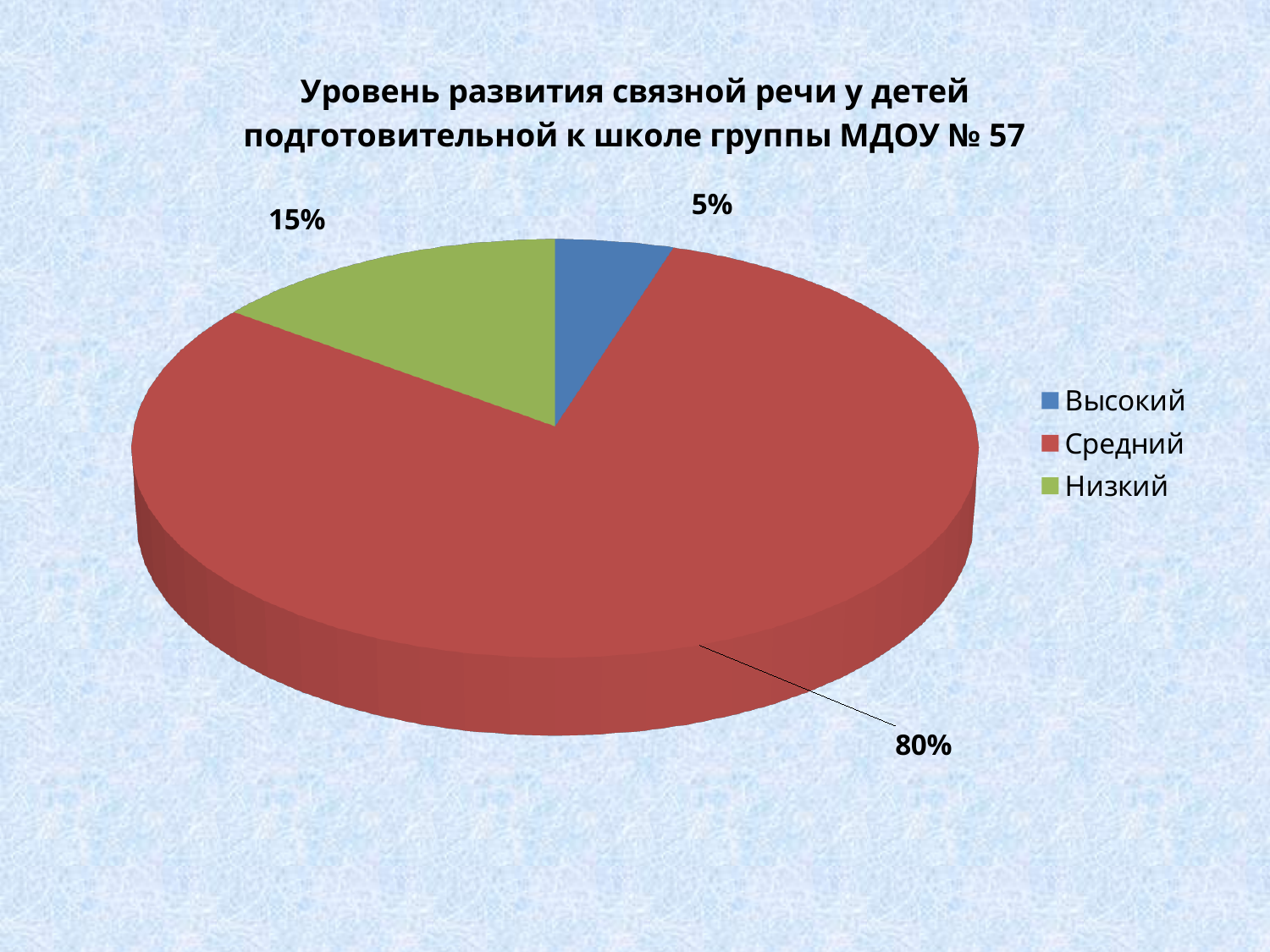
What share of the pie does the Средний slice have? 80% Which category has the smallest slice of the pie? Высокий How many categories does the legend list? 3 Which category has the largest slice of the pie? Средний What share of the pie does the Высокий slice have? 5% What share of the pie does the Низкий slice have? 15% Which is larger, the Низкий slice or the Высокий slice? Низкий What is the difference between the Низкий and Высокий shares? 10% What is the difference between the Средний and Низкий shares? 65% What is the title of the chart? Уровень развития связной речи у детей подготовительной к школе группы МДОУ № 57 What colour is the Низкий slice? green What kind of chart is shown on the slide? pie chart